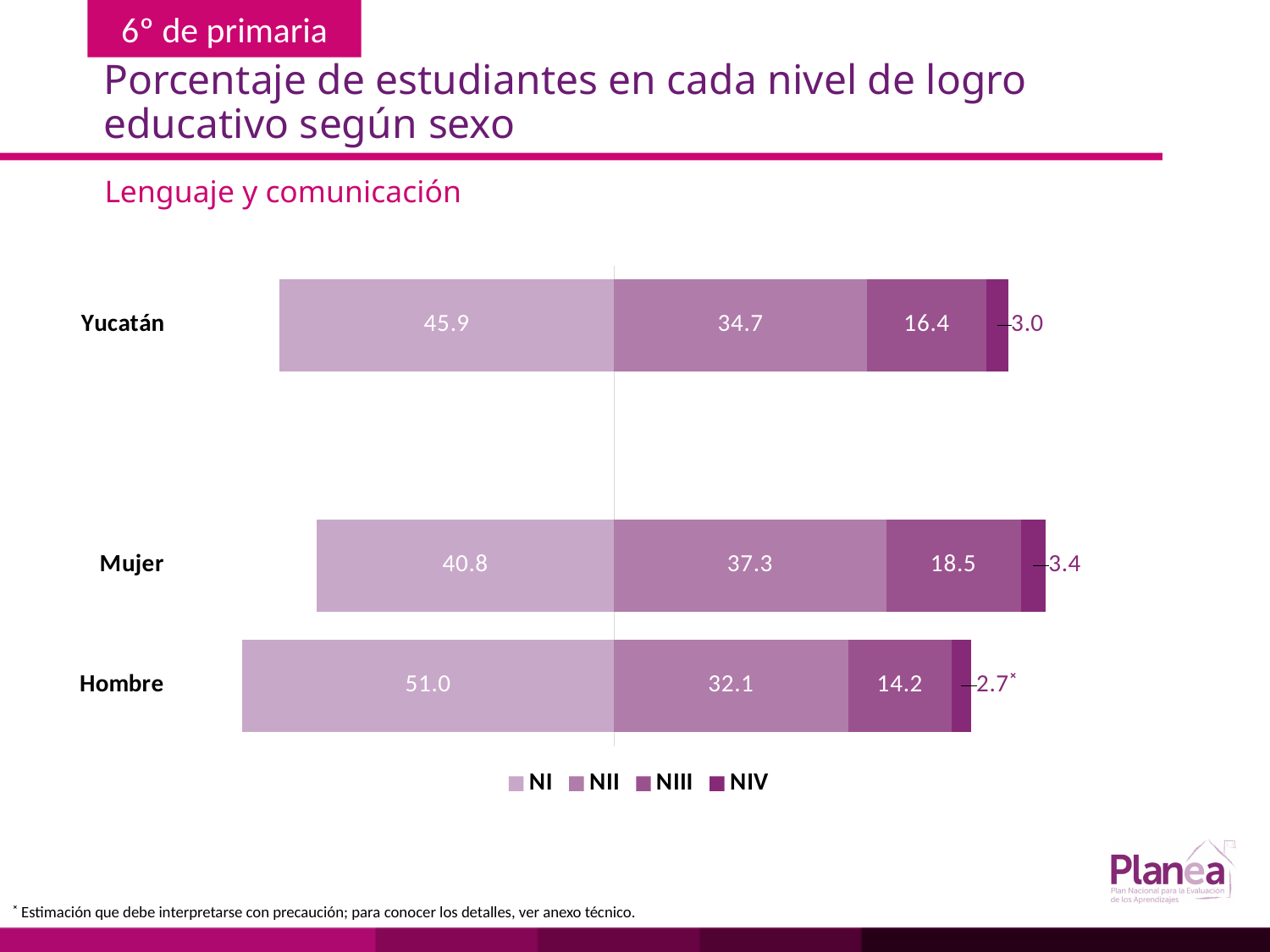
Which is larger, the NIV value for Mujer or the NIV value for Yucatán? Mujer What is the difference between the NI values for Hombre and Mujer? 10.2 How many categories (bars) are shown in the chart? 3 What is the total of the stacked bar for Mujer? 100.0 How many series does the legend list? 4 What is the NIII value for Yucatán? 16.4 What is the NI value for Hombre? 51.0 Which category has the highest NI value? Hombre Which category has the lowest NIII value? Hombre What is the NIV value for Hombre? 2.7 What kind of chart is shown on the slide? stacked bar chart What is the NII value for Mujer? 37.3